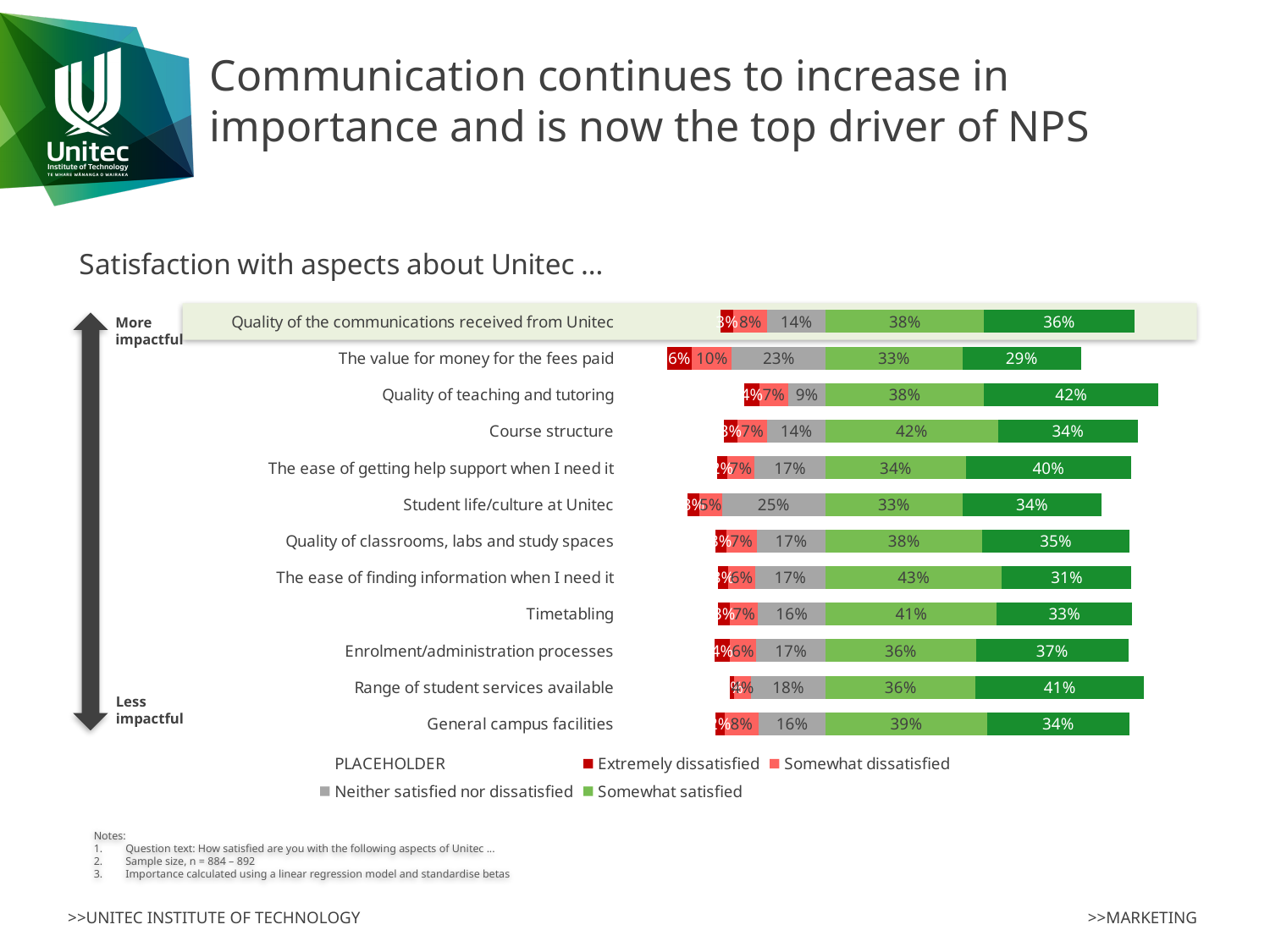
Which has the larger 'Somewhat satisfied' value: 'The ease of finding information when I need it' or 'Timetabling'? The ease of finding information when I need it Which aspect has the lowest dark green (rightmost) value? The value for money for the fees paid How many entries does the chart legend list? 5 What is the 'Somewhat dissatisfied' value for 'The value for money for the fees paid'? 10% What is the 'Neither satisfied nor dissatisfied' value for 'Student life/culture at Unitec'? 25% Which aspect has the highest 'Neither satisfied nor dissatisfied' value? Student life/culture at Unitec Which aspect is placed at the top of the chart as the most impactful? Quality of the communications received from Unitec For 'Course structure', what is the difference between the 'Somewhat satisfied' value and the dark green (rightmost) value? 8 percentage points What kind of chart is shown on the slide? Stacked bar chart What is the 'Neither satisfied nor dissatisfied' value for 'Quality of the communications received from Unitec'? 14% What is the dark green (rightmost) value for 'Quality of teaching and tutoring'? 42% How many aspects of Unitec are listed as categories in the chart? 12